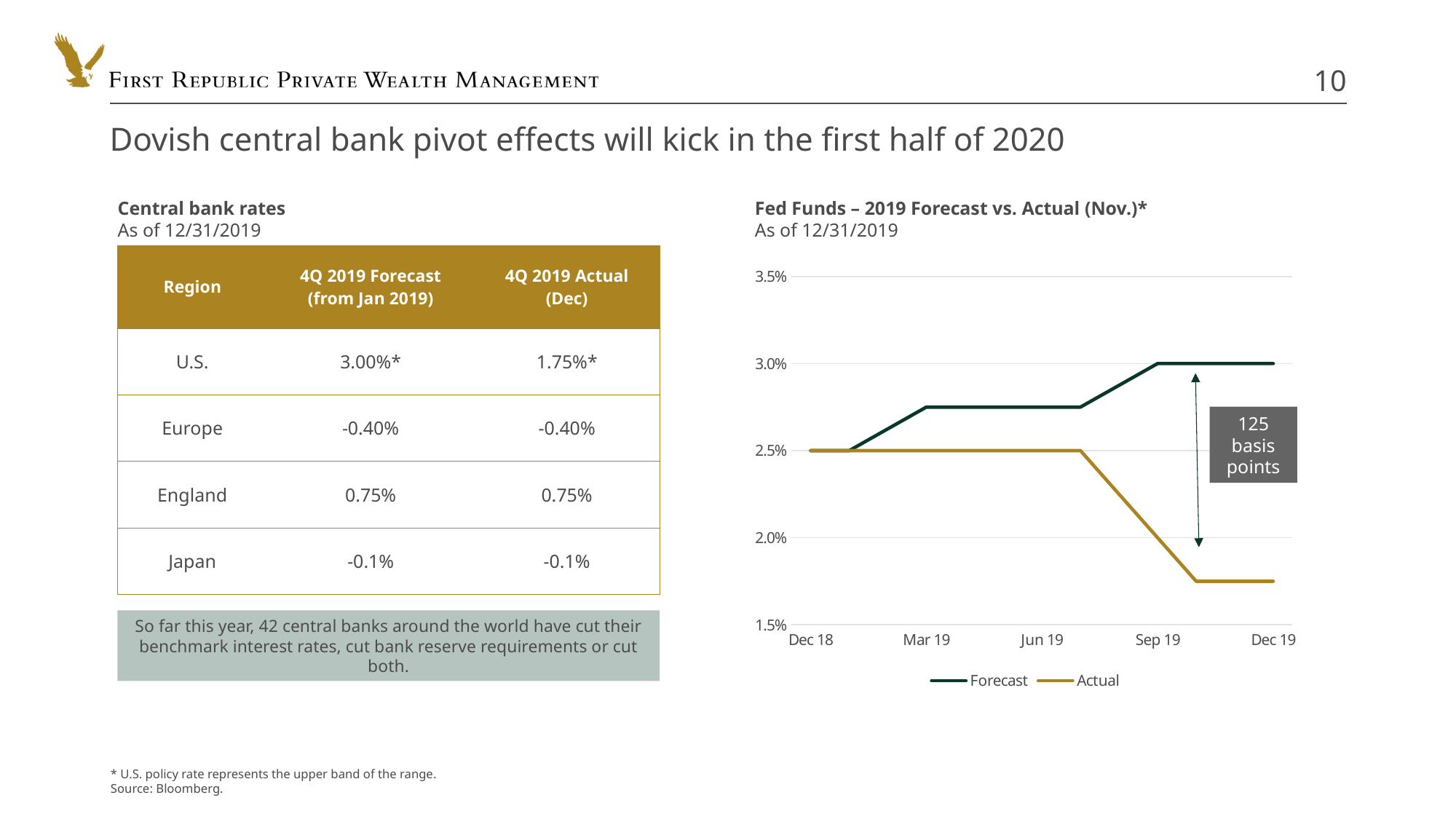
In the Fed Funds chart, does the Forecast series rise or fall from Dec 18 to Dec 19? Rise In the Fed Funds chart, what is the Forecast value at Dec 18? 2.5% In the Fed Funds chart, is the Actual value at Dec 19 greater or less than 2.0%? less How many labels are shown on the x axis of the Fed Funds chart? 5 What are the two series named in the legend of the Fed Funds chart? Forecast and Actual What kind of chart is shown under the title "Fed Funds – 2019 Forecast vs. Actual (Nov.)*"? Line chart In the Fed Funds chart, does the Actual series rise or fall between Jun 19 and Dec 19? Fall In the Fed Funds chart, is the Forecast value at Mar 19 greater or less than 2.5%? greater How many series does the legend of the Fed Funds chart list? 2 In the Fed Funds chart, what is the Actual value at Dec 18? 2.5% In the Fed Funds chart, what is the Forecast value at Dec 19? 3.0% In the Fed Funds chart, which series is higher at Dec 19, Forecast or Actual? Forecast